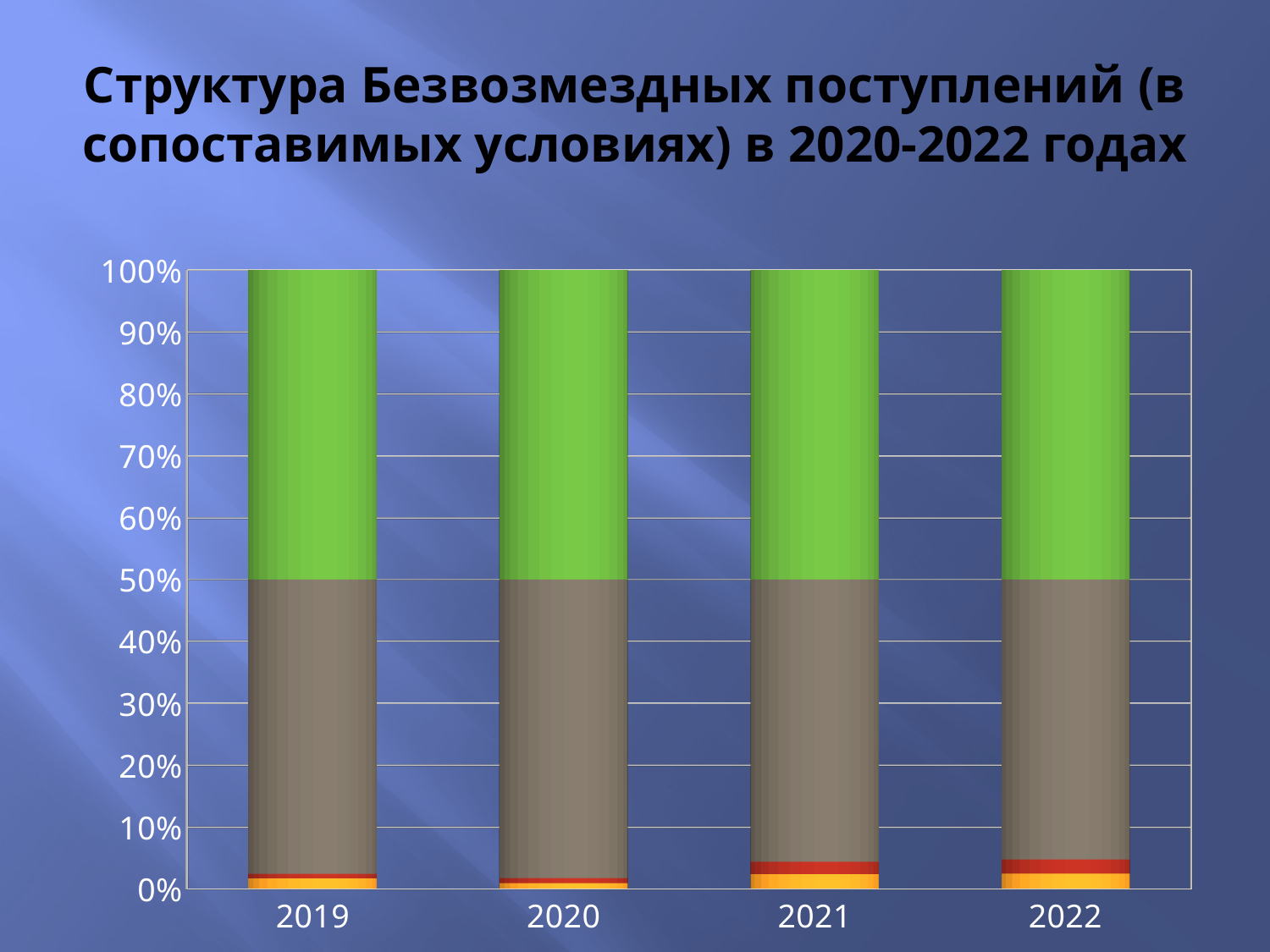
What is the first year shown on the x axis of the chart? 2019 Is the combined height of the red and yellow segments in the 2020 bar greater or less than 10%? less Is the combined height of the red and yellow segments in the 2021 bar greater or less than 10%? less Which segment is larger in the 2021 bar: the green segment or the red segment? green What kind of chart is shown on the slide? stacked bar chart What is the highest value shown on the vertical axis of the chart? 100% Does the combined red and yellow portion at the bottom of the bars rise or fall from 2020 to 2022? rise Which year has the smallest combined red and yellow segment at the bottom of its bar? 2020 How many years (categories) are shown on the x axis of the chart? 4 Is the top of the brown segment in the 2019 bar greater or less than 60%? less What is the title of the chart slide? Структура Безвозмездных поступлений (в сопоставимых условиях) в 2020-2022 годах